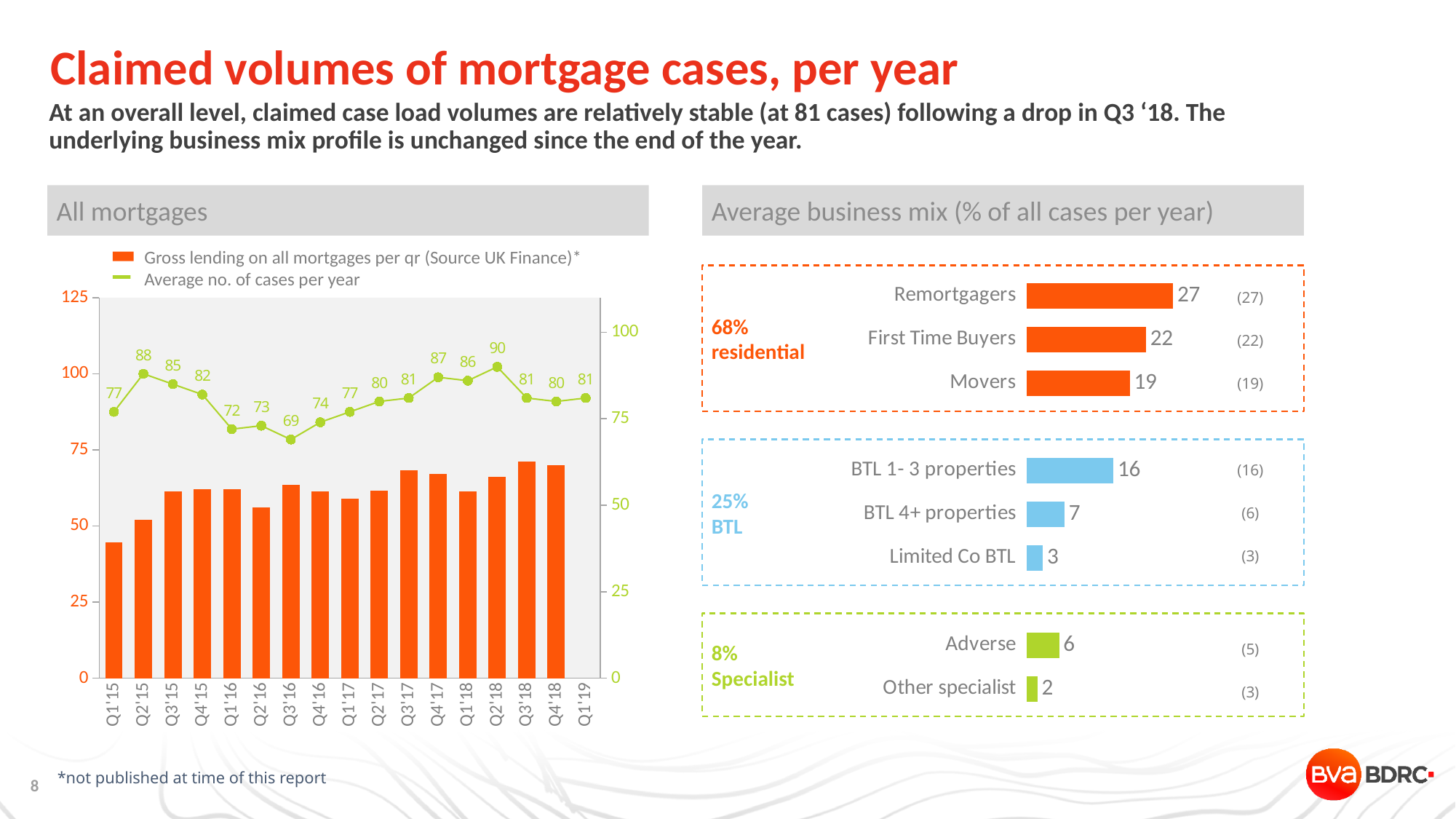
In the 'Average business mix' chart, which category has the highest value? Remortgagers In the 'All mortgages' chart, what is the average number of cases per year for Q2'18? 90 In the 'All mortgages' chart, which quarter has the highest average number of cases per year? Q2'18 In the 'All mortgages' chart, is the gross lending bar for Q1'15 greater or less than 50 on the left axis? less What kind of chart is the 'Average business mix' chart? bar chart In the 'All mortgages' chart, how many series does the legend list? 2 In the 'Average business mix' chart, what is the difference between Remortgagers and Movers? 8 In the 'Average business mix' chart, what is the value for First Time Buyers? 22 In the 'All mortgages' chart, what is the difference between the average number of cases per year in Q2'15 and Q1'16? 16 In the 'All mortgages' chart, what is the average number of cases per year for Q3'16? 69 In the 'All mortgages' chart, which quarter has the lowest average number of cases per year? Q3'16 In the 'All mortgages' chart, how many quarters are shown on the x axis? 17